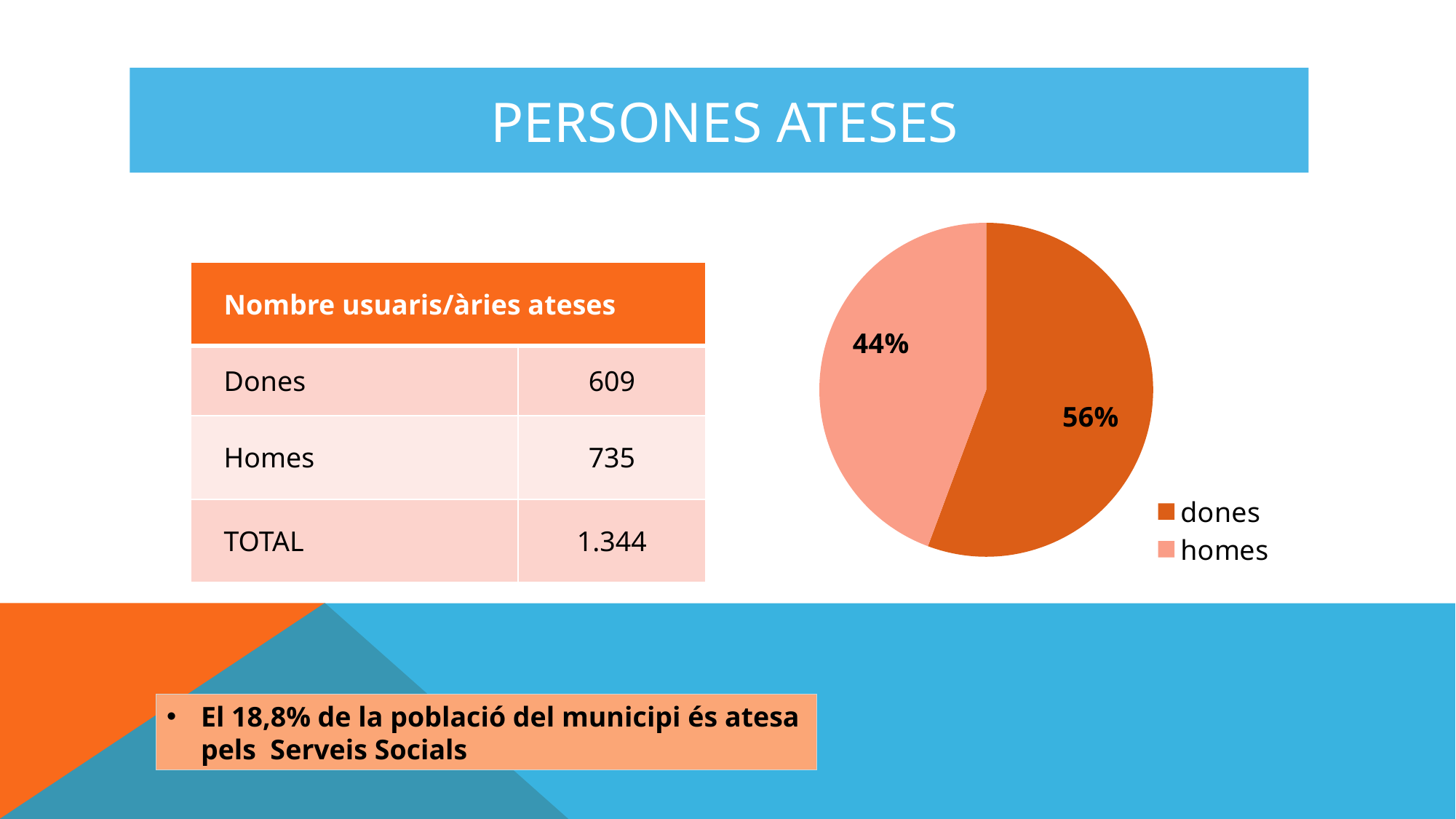
Which category has the smallest slice in the pie chart? homes How many slices does the pie chart have? 2 Which slice of the pie chart is larger, "dones" or "homes"? dones What are the two legend entries of the pie chart? dones, homes What share of the pie chart does the "homes" slice represent? 44% Which category has the largest slice in the pie chart? dones What kind of chart is shown on the slide? pie chart How many entries does the pie chart's legend list? 2 By how many percentage points does the "dones" slice exceed the "homes" slice in the pie chart? 12 Is the share of the "dones" slice in the pie chart greater or less than 50%? greater Which colour represents "dones" in the pie chart's legend? dark orange What share of the pie chart does the "dones" slice represent? 56%